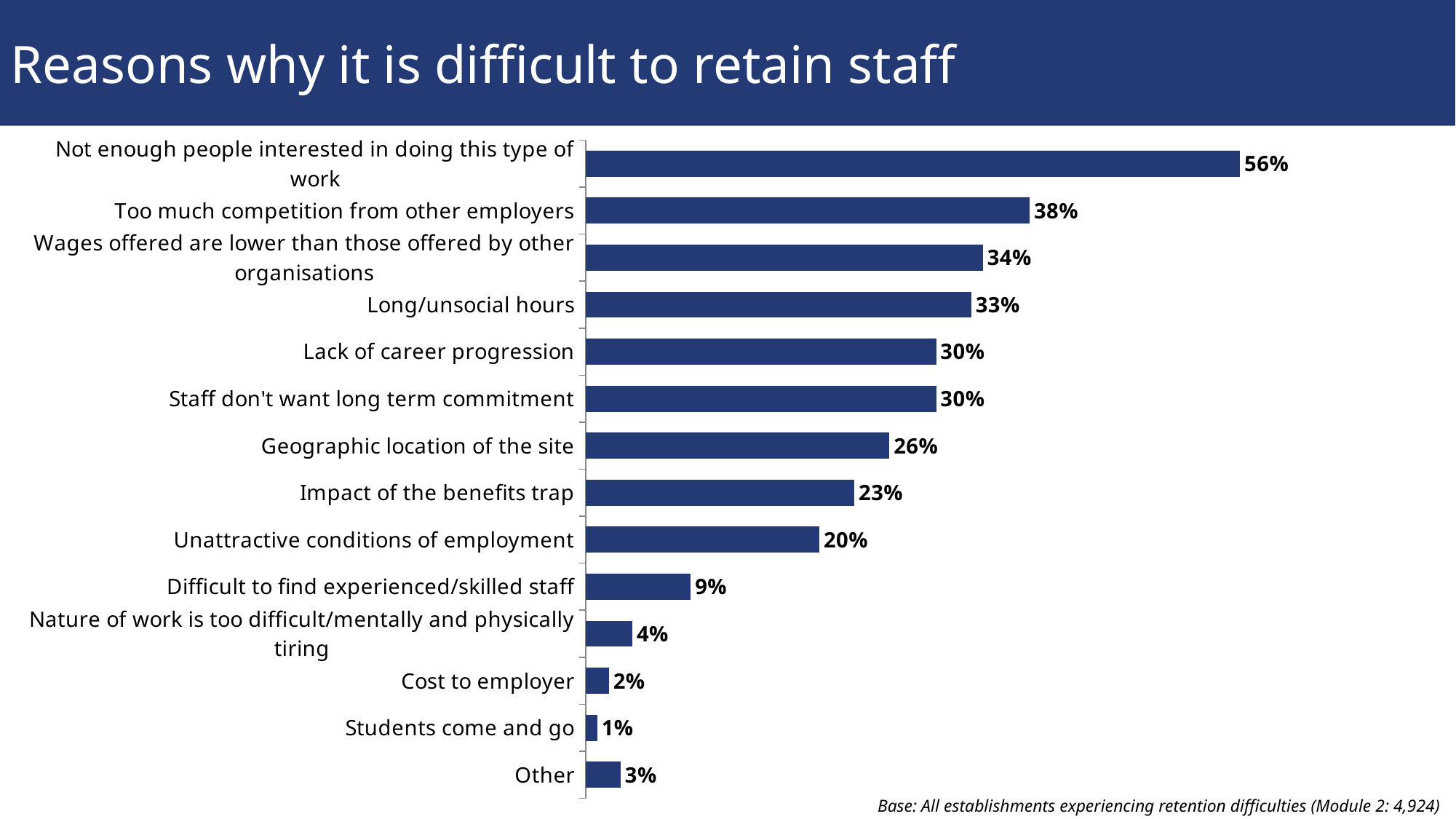
What percentage is shown for 'Too much competition from other employers'? 38% What is the value for 'Geographic location of the site'? 26% Which reason has the lowest percentage? Students come and go What is the title of the slide? Reasons why it is difficult to retain staff Which is larger: 'Cost to employer' or 'Other'? Other Which reason has the highest percentage? Not enough people interested in doing this type of work What percentage is shown for 'Difficult to find experienced/skilled staff'? 9% What is the difference between 'Not enough people interested in doing this type of work' and 'Too much competition from other employers'? 18% What type of chart is shown on the slide? Bar chart What is the difference between 'Impact of the benefits trap' and 'Unattractive conditions of employment'? 3% How many reasons are listed in the chart? 14 Which is larger: 'Wages offered are lower than those offered by other organisations' or 'Long/unsocial hours'? Wages offered are lower than those offered by other organisations